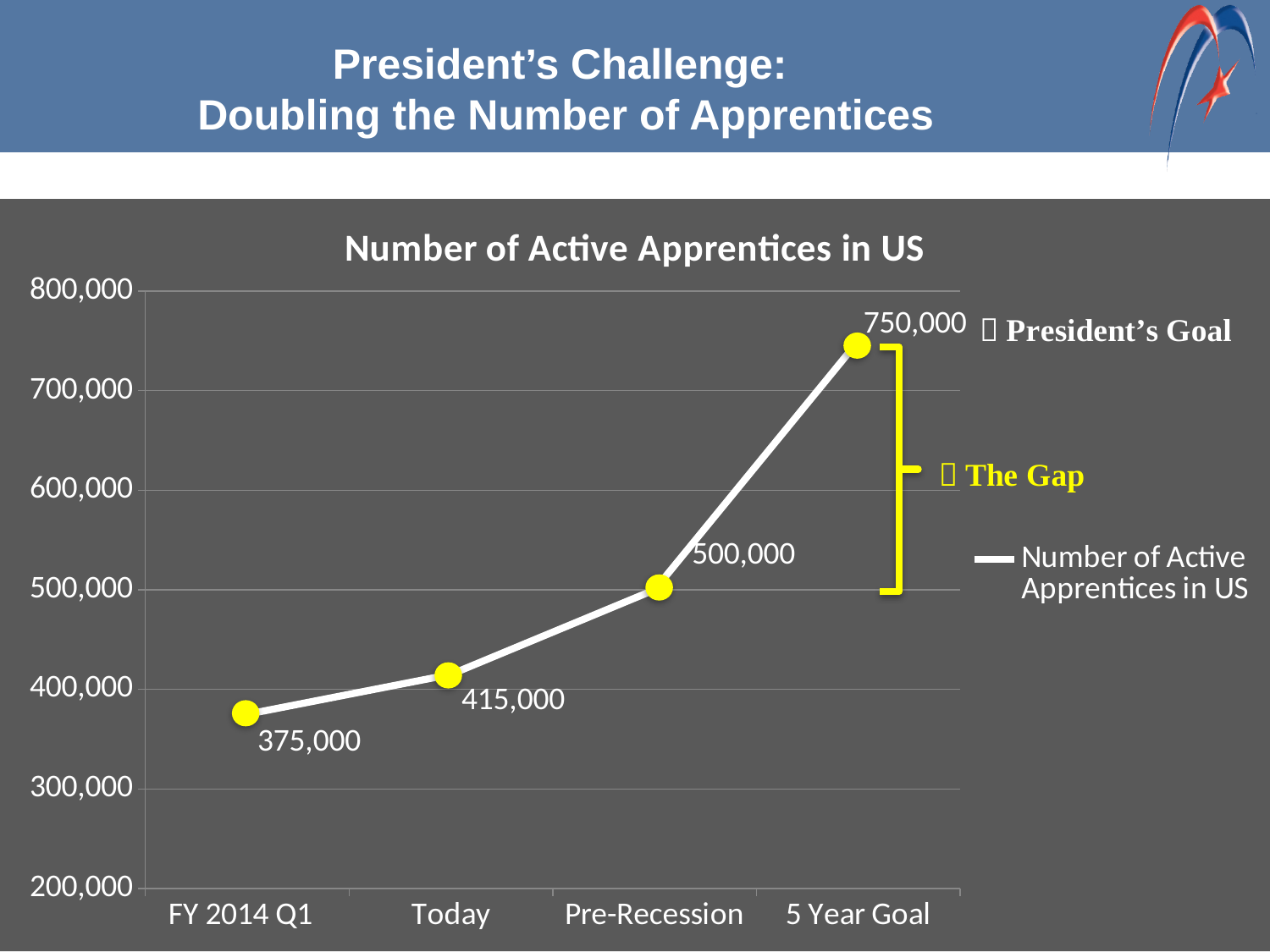
Which category has the highest number of active apprentices? 5 Year Goal What is the number of active apprentices for Pre-Recession? 500,000 Which category has the lowest number of active apprentices? FY 2014 Q1 What kind of chart is shown on the slide? Line chart What is the number of active apprentices for Today? 415,000 How many data points are plotted on the chart? 4 What is the difference between the 5 Year Goal and the Pre-Recession value? 250,000 What is the number of active apprentices for FY 2014 Q1? 375,000 Which is larger, the value for Today or the value for Pre-Recession? Pre-Recession Do the values rise or fall from FY 2014 Q1 to 5 Year Goal? Rise What is the difference between the Today value and the FY 2014 Q1 value? 40,000 What is the value for the 5 Year Goal? 750,000